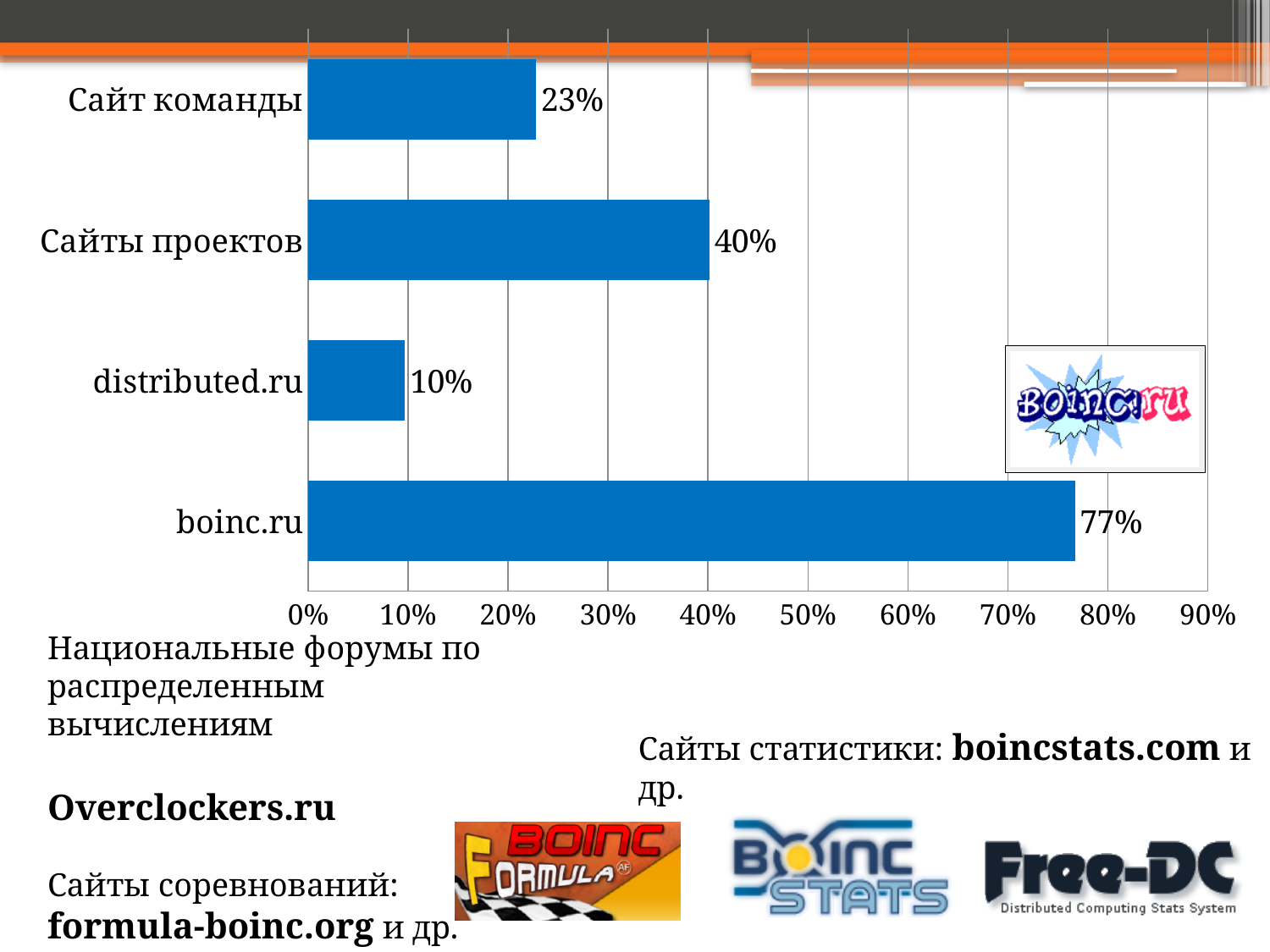
What is the difference between the values for Сайт команды and distributed.ru? 13% How many categories are shown in the chart? 4 Is the value for boinc.ru greater or less than 70%? greater Which category has the highest value? boinc.ru What is the value for Сайты проектов? 40% What is the value for boinc.ru? 77% What kind of chart is shown on the slide? bar chart What is the value for distributed.ru? 10% What is the value for Сайт команды? 23% Which is larger, the value for Сайты проектов or the value for Сайт команды? Сайты проектов What is the difference between the values for boinc.ru and Сайты проектов? 37% Which category has the lowest value? distributed.ru